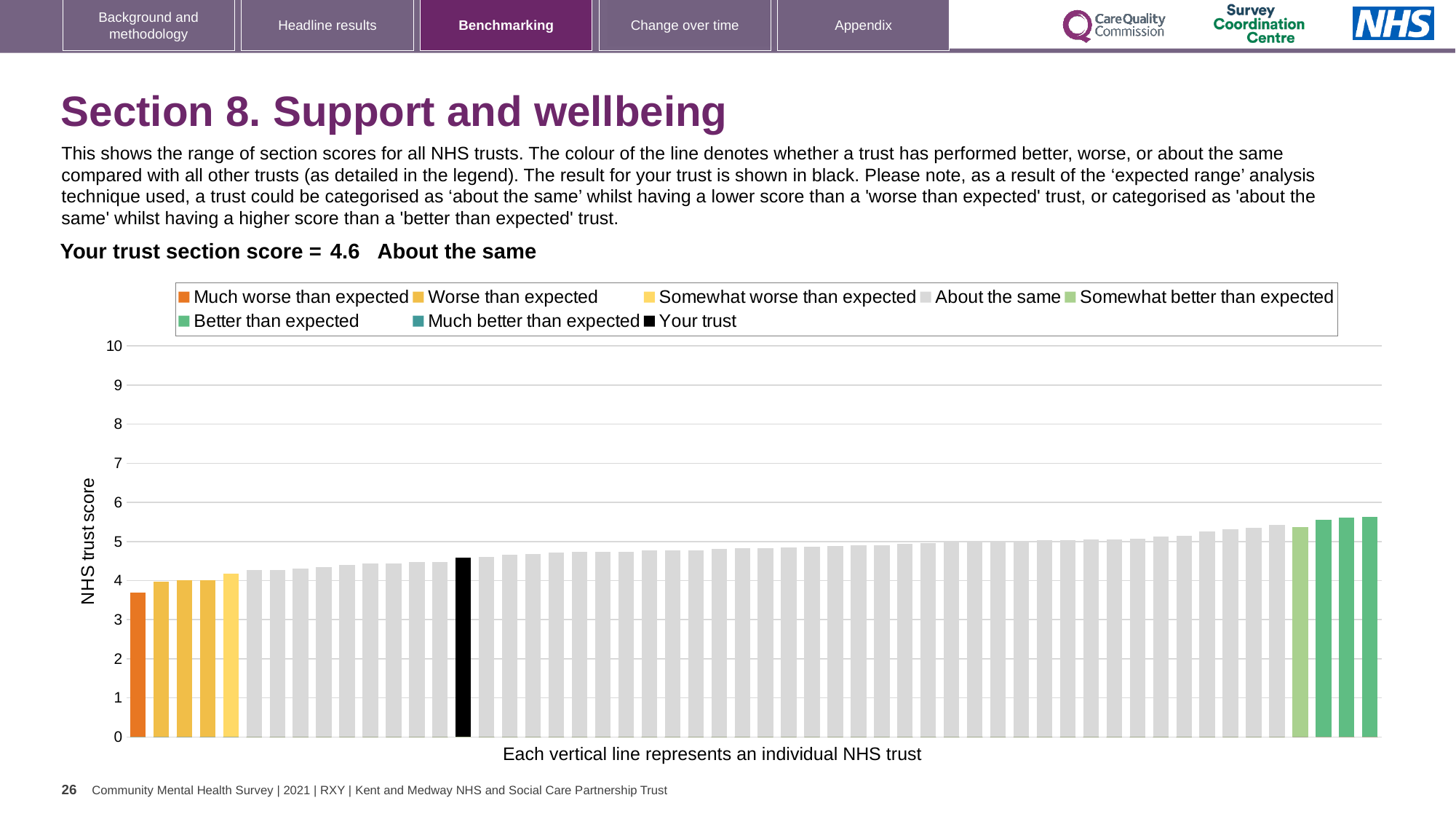
Do the bar values rise or fall from left to right along the x axis? rise Is the value of the tallest bar (at the far right) greater or less than 6? less Is the value of the shortest bar (the orange bar at the far left) greater or less than 4? less What is the section score for your trust shown on the slide? 4.6 What is the label on the vertical axis of the chart? NHS trust score Is the value for your trust (the black bar) greater or less than 4? greater What kind of chart is shown on the slide? bar chart How many entries does the chart legend list? 8 Which legend category does the shortest bar belong to? Much worse than expected Which legend category does the tallest bar belong to? Better than expected